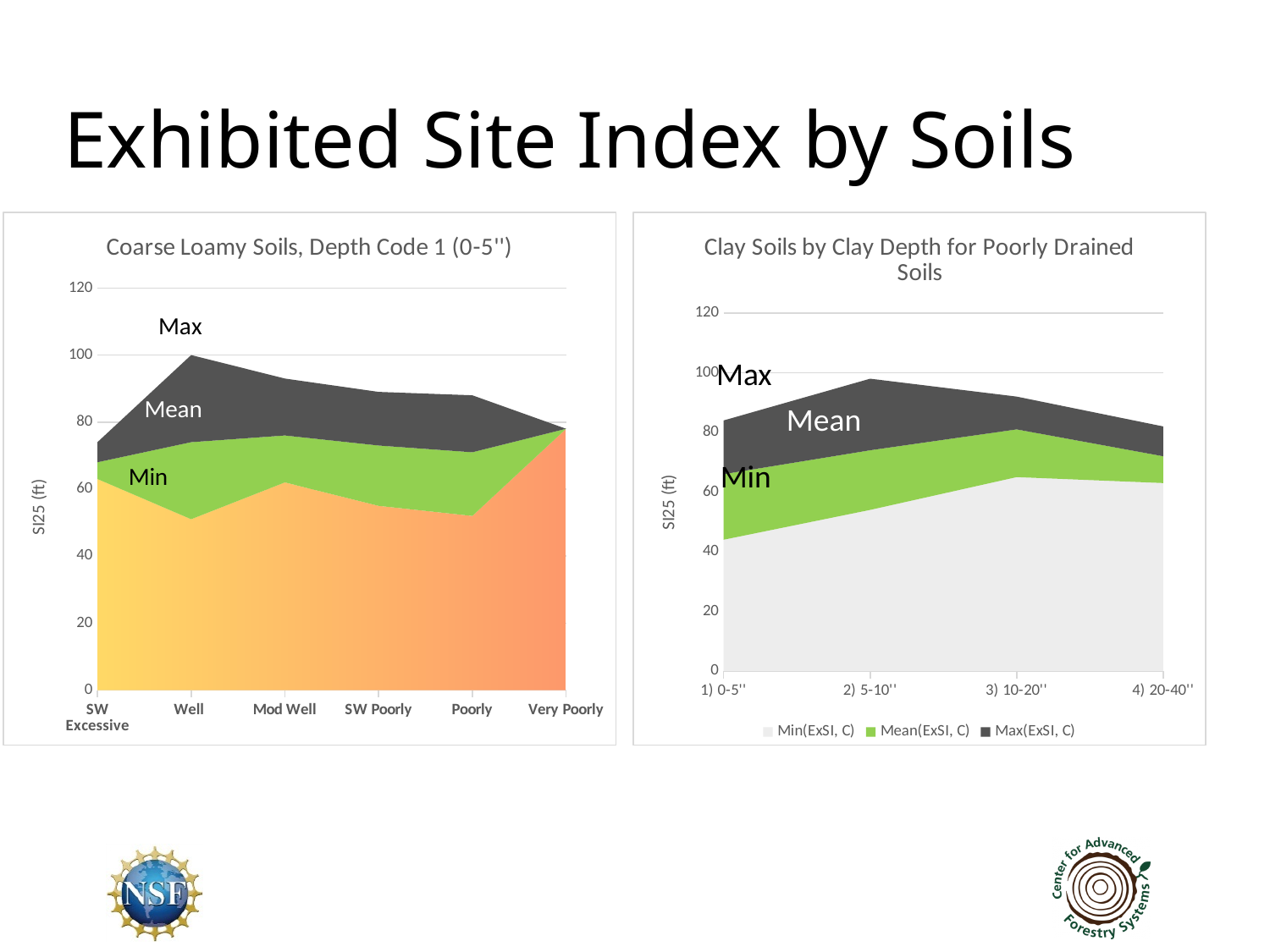
In the right chart, 'Clay Soils by Clay Depth for Poorly Drained Soils', does the Min series rise or fall from 1) 0-5'' to 3) 10-20''? rise How many series does the legend of the right chart, 'Clay Soils by Clay Depth for Poorly Drained Soils', list? 3 In the left chart, 'Coarse Loamy Soils, Depth Code 1 (0-5'')', is the Max value for SW Excessive greater or less than 80? less How many clay depth categories are shown on the x axis of the right chart, 'Clay Soils by Clay Depth for Poorly Drained Soils'? 4 In the left chart, 'Coarse Loamy Soils, Depth Code 1 (0-5'')', is the Min value for Well greater or less than 60? less In the right chart, 'Clay Soils by Clay Depth for Poorly Drained Soils', at which category is the Max series highest? 2) 5-10'' What is the y-axis label on the left chart, 'Coarse Loamy Soils, Depth Code 1 (0-5'')'? SI25 (ft) What kind of chart is the left chart, 'Coarse Loamy Soils, Depth Code 1 (0-5'')'? Area chart How many drainage categories are shown on the x axis of the left chart, 'Coarse Loamy Soils, Depth Code 1 (0-5'')'? 6 In the left chart, 'Coarse Loamy Soils, Depth Code 1 (0-5'')', at which category is the Max series highest? Well In the right chart, 'Clay Soils by Clay Depth for Poorly Drained Soils', is the Min value for 1) 0-5'' greater or less than 40? greater In the right chart, 'Clay Soils by Clay Depth for Poorly Drained Soils', at which category is the Min series lowest? 1) 0-5''